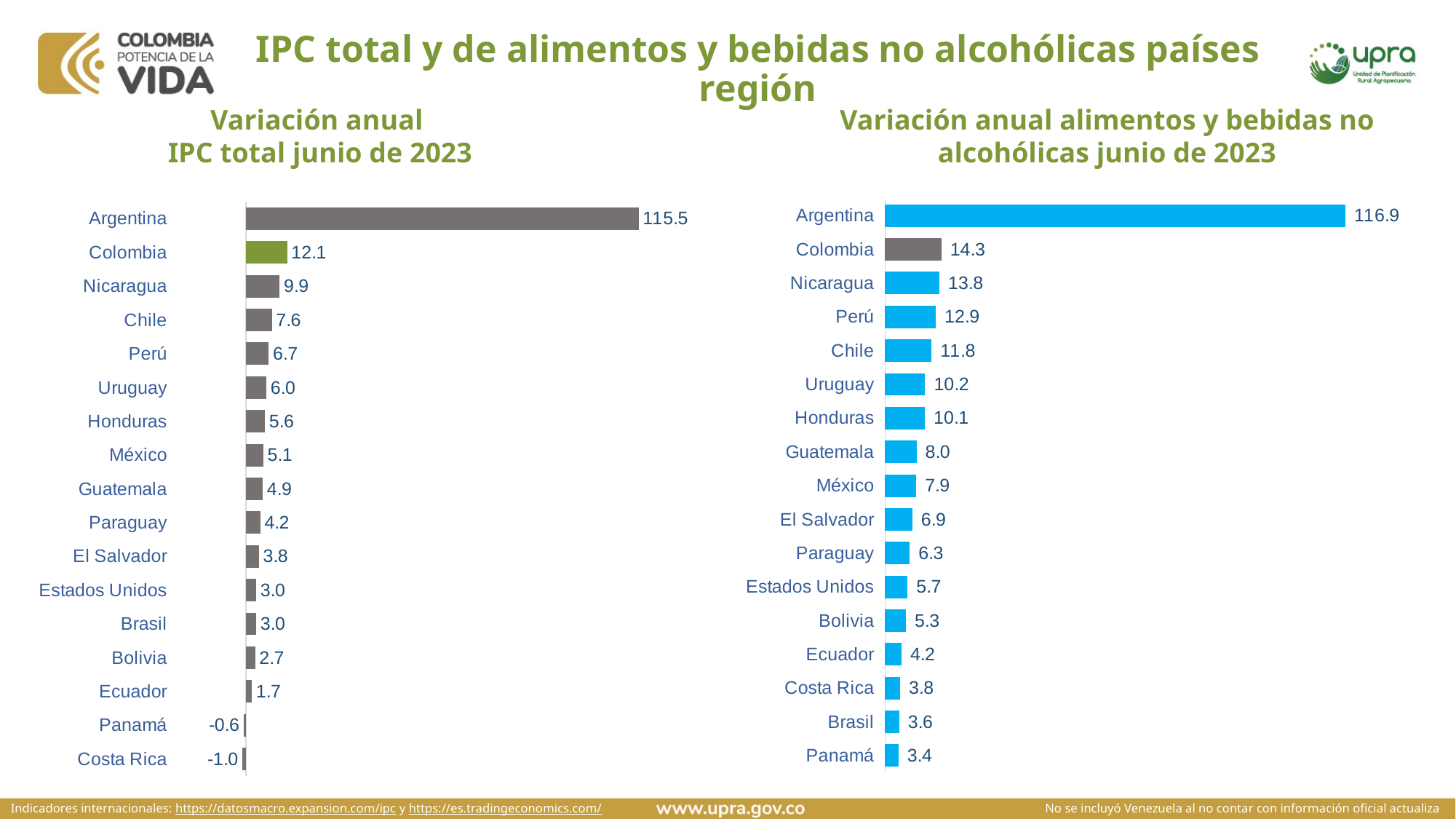
In the 'Variación anual alimentos y bebidas no alcohólicas junio de 2023' chart, which country has the lowest value? Panamá In the 'Variación anual IPC total junio de 2023' chart, which country has the highest value? Argentina In the 'Variación anual IPC total junio de 2023' chart, what is the difference between Nicaragua and Chile? 2.3 In the 'Variación anual IPC total junio de 2023' chart, which country has the lowest value? Costa Rica In the 'Variación anual IPC total junio de 2023' chart, what is the value for Panamá? -0.6 In the 'Variación anual alimentos y bebidas no alcohólicas junio de 2023' chart, what is the difference between Argentina and Colombia? 102.6 How many countries are shown in the 'Variación anual IPC total junio de 2023' chart? 17 In the 'Variación anual IPC total junio de 2023' chart, which country's bar is coloured green? Colombia What type of chart is the 'Variación anual alimentos y bebidas no alcohólicas junio de 2023' chart? Bar chart In the 'Variación anual alimentos y bebidas no alcohólicas junio de 2023' chart, what is the value for Perú? 12.9 In the 'Variación anual alimentos y bebidas no alcohólicas junio de 2023' chart, which is larger, Uruguay or Guatemala? Uruguay In the 'Variación anual IPC total junio de 2023' chart, what is the value for Colombia? 12.1